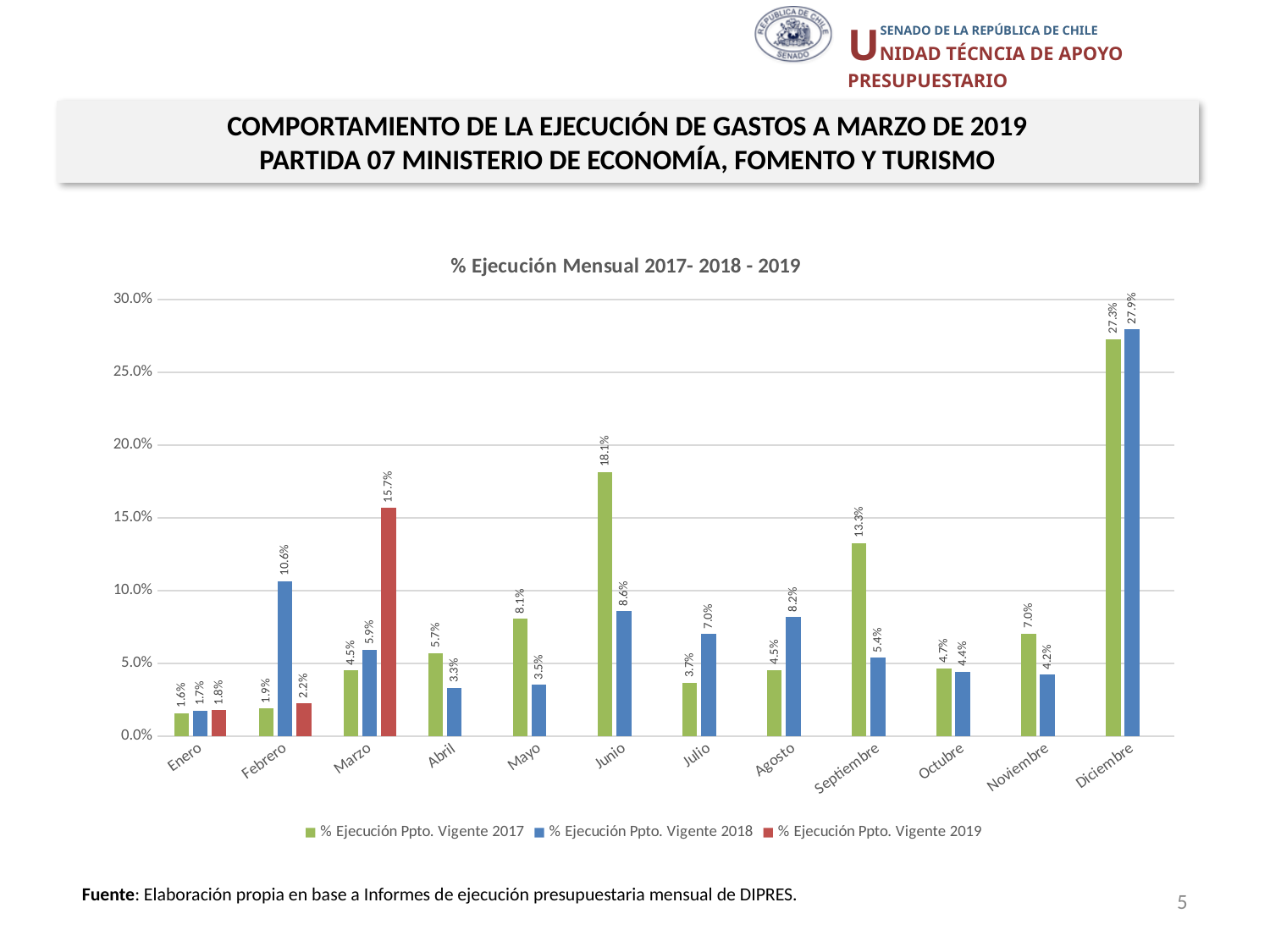
Is the value for % Ejecución Ppto. Vigente 2017 in Junio greater or less than 15.0%? greater What is the difference between the 2018 and 2017 values in Diciembre? 0.6% Which month has the lowest value for % Ejecución Ppto. Vigente 2018? Enero What is the value for % Ejecución Ppto. Vigente 2017 in Junio? 18.1% Which is larger in Septiembre: the 2017 value or the 2018 value? 2017 What kind of chart is shown on the slide? Bar chart What is the value for % Ejecución Ppto. Vigente 2018 in Febrero? 10.6% Which month has the highest value for % Ejecución Ppto. Vigente 2017? Diciembre How many series does the legend list? 3 What is the title of the chart? % Ejecución Mensual 2017- 2018 - 2019 How many months are shown on the x axis? 12 What is the value for % Ejecución Ppto. Vigente 2019 in Marzo? 15.7%